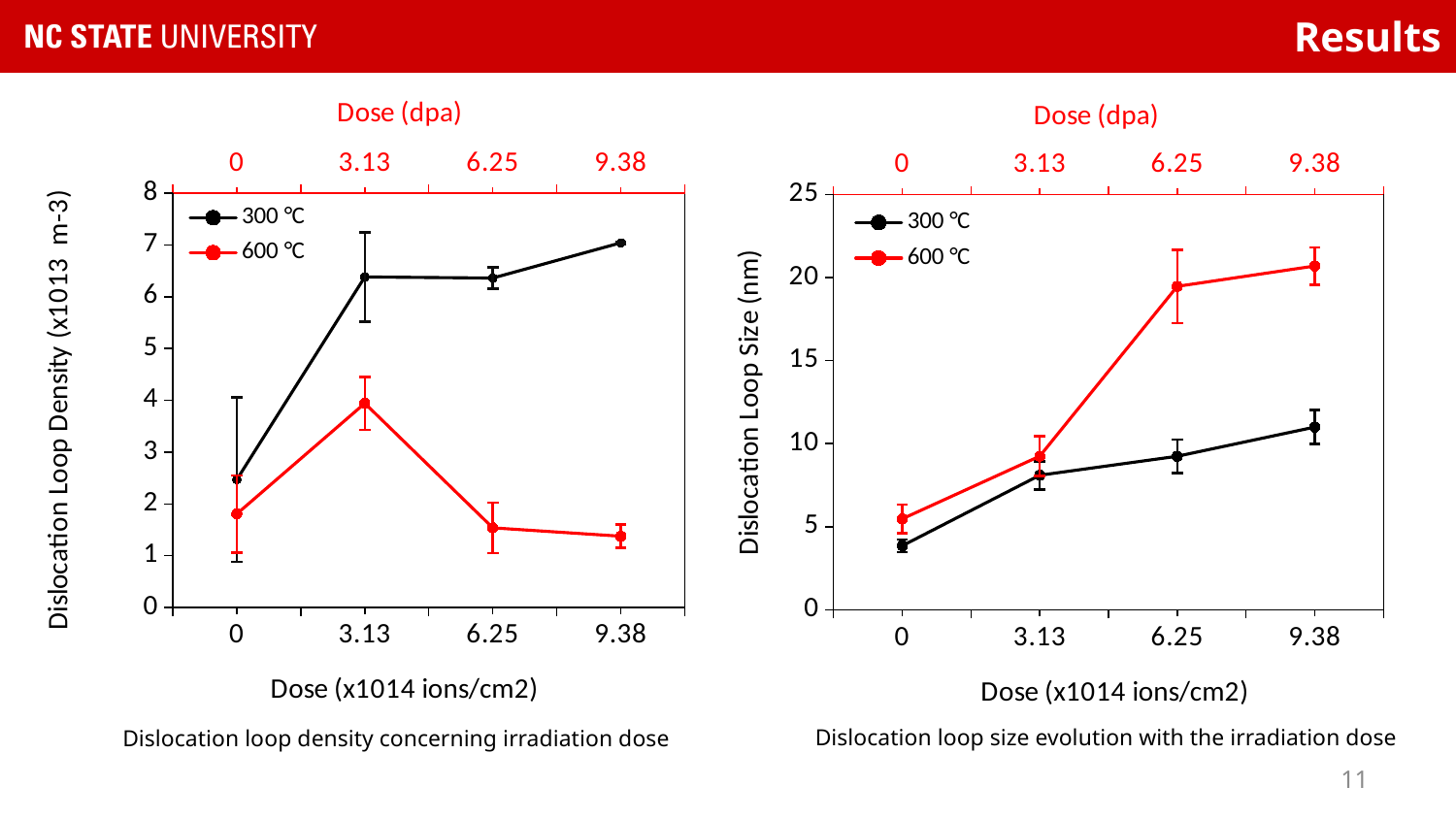
What kind of chart is the left chart, 'Dislocation loop density concerning irradiation dose'? Line chart In the left chart, 'Dislocation loop density concerning irradiation dose', is the 600 °C value at dose 6.25 greater or less than 2? less In the left chart, 'Dislocation loop density concerning irradiation dose', at which dose is the 600 °C series highest? 3.13 In the right chart, 'Dislocation loop size evolution with the irradiation dose', does the 600 °C series rise or fall as dose increases? Rises In the right chart, 'Dislocation loop size evolution with the irradiation dose', is the 300 °C value at dose 0 greater or less than 5? less In the right chart, 'Dislocation loop size evolution with the irradiation dose', at which dose is the 300 °C series highest? 9.38 In the left chart, 'Dislocation loop density concerning irradiation dose', which series has the higher value at dose 6.25? 300 °C In the right chart, 'Dislocation loop size evolution with the irradiation dose', is the 600 °C value at dose 6.25 greater or less than 15? greater In the left chart, 'Dislocation loop density concerning irradiation dose', how many dose points are plotted for each series? 4 In the left chart, 'Dislocation loop density concerning irradiation dose', how many series does the legend list? 2 What is the y-axis label of the right chart, 'Dislocation loop size evolution with the irradiation dose'? Dislocation Loop Size (nm)